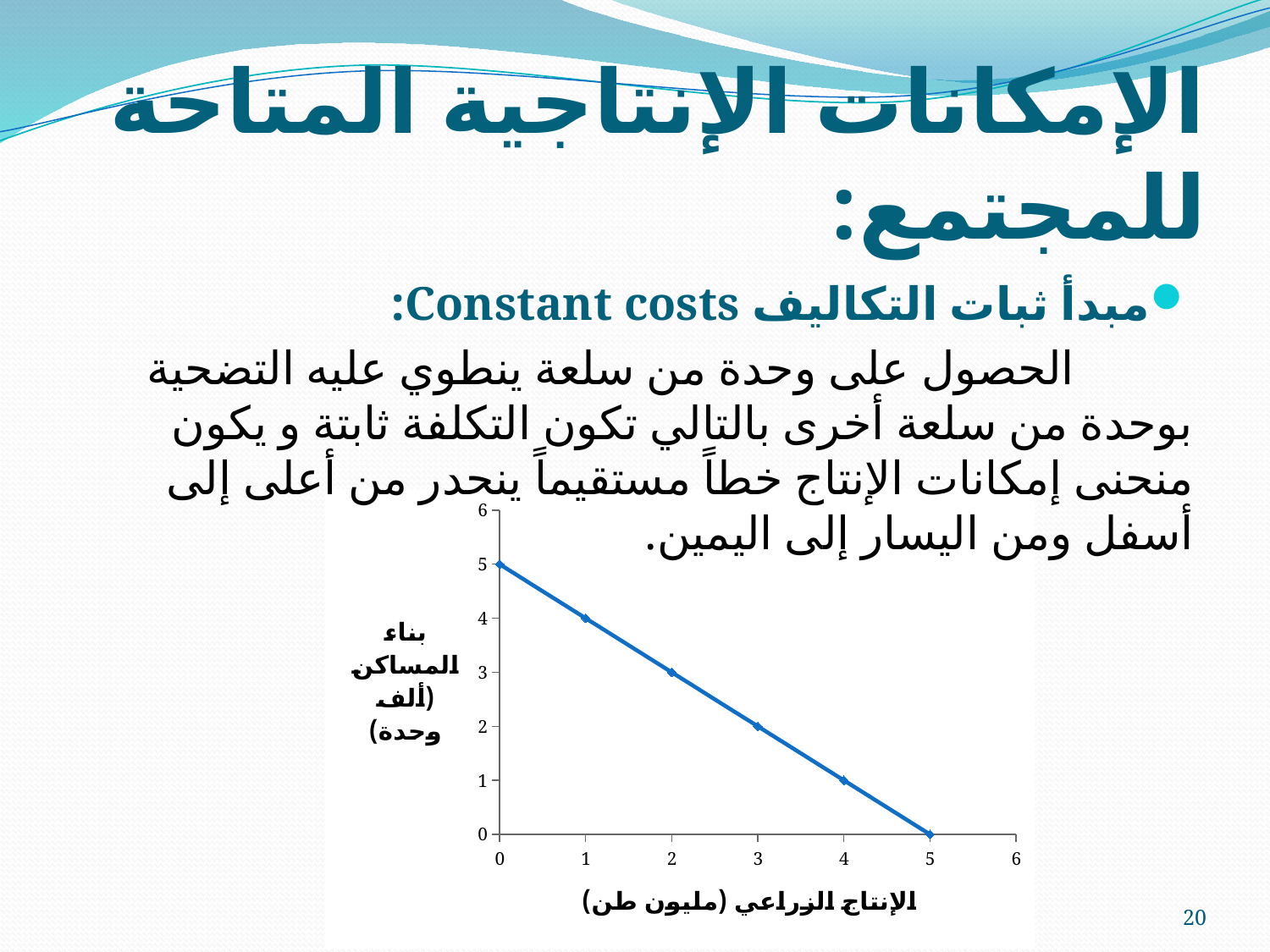
What is the difference in housing construction between agricultural production of 1 and agricultural production of 4? 3 At which value of agricultural production is housing construction lowest? 5 At which value of agricultural production is housing construction highest? 0 How many data points are plotted on the line? 6 What is the label of the y axis? بناء المساكن (ألف وحدة) What is the value of housing construction when agricultural production is 5? 0 Which is larger: housing construction at agricultural production 2 or at agricultural production 4? agricultural production 2 What is the label of the x axis? الإنتاج الزراعي (مليون طن) What kind of chart is shown on the slide? line chart What is the value of housing construction when agricultural production is 3? 2 What is the value of housing construction (بناء المساكن) when agricultural production (الإنتاج الزراعي) is 0? 5 Do the values rise or fall as agricultural production increases along the x axis? fall